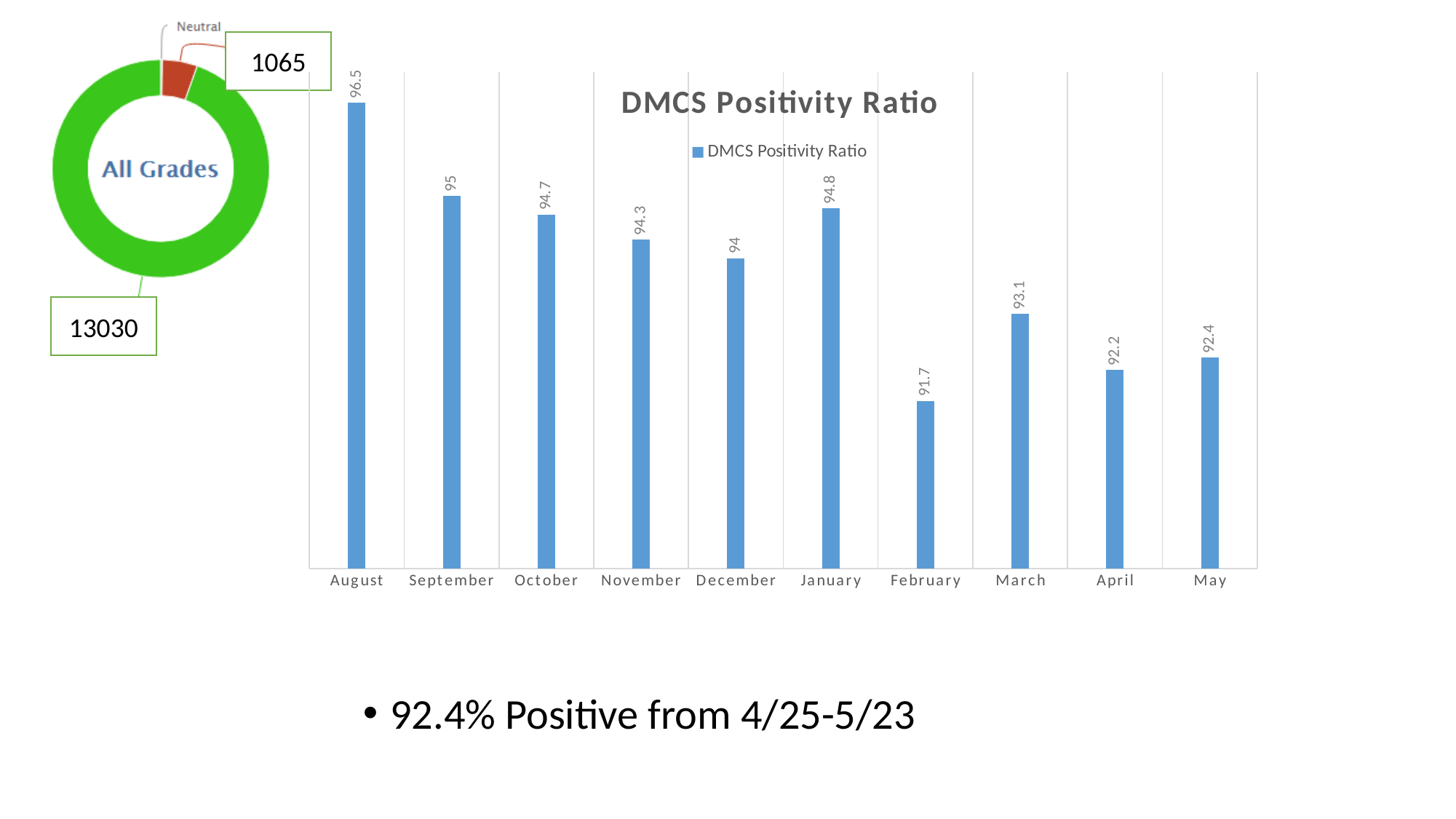
In the DMCS Positivity Ratio chart, which month has the highest value? August In the DMCS Positivity Ratio chart, which is larger, the value for March or the value for April? March In the DMCS Positivity Ratio chart, what is the value for August? 96.5 In the All Grades donut chart on the left, what value is labelled for the red slice? 1065 In the DMCS Positivity Ratio chart, what is the value for January? 94.8 What kind of chart is the DMCS Positivity Ratio chart? Bar chart How many months are shown on the x axis of the DMCS Positivity Ratio chart? 10 In the DMCS Positivity Ratio chart, what is the value for February? 91.7 How many series does the legend of the DMCS Positivity Ratio chart list? 1 In the DMCS Positivity Ratio chart, which month has the lowest value? February In the DMCS Positivity Ratio chart, what is the difference between the values for August and February? 4.8 In the DMCS Positivity Ratio chart, do the values rise or fall from August to December? Fall